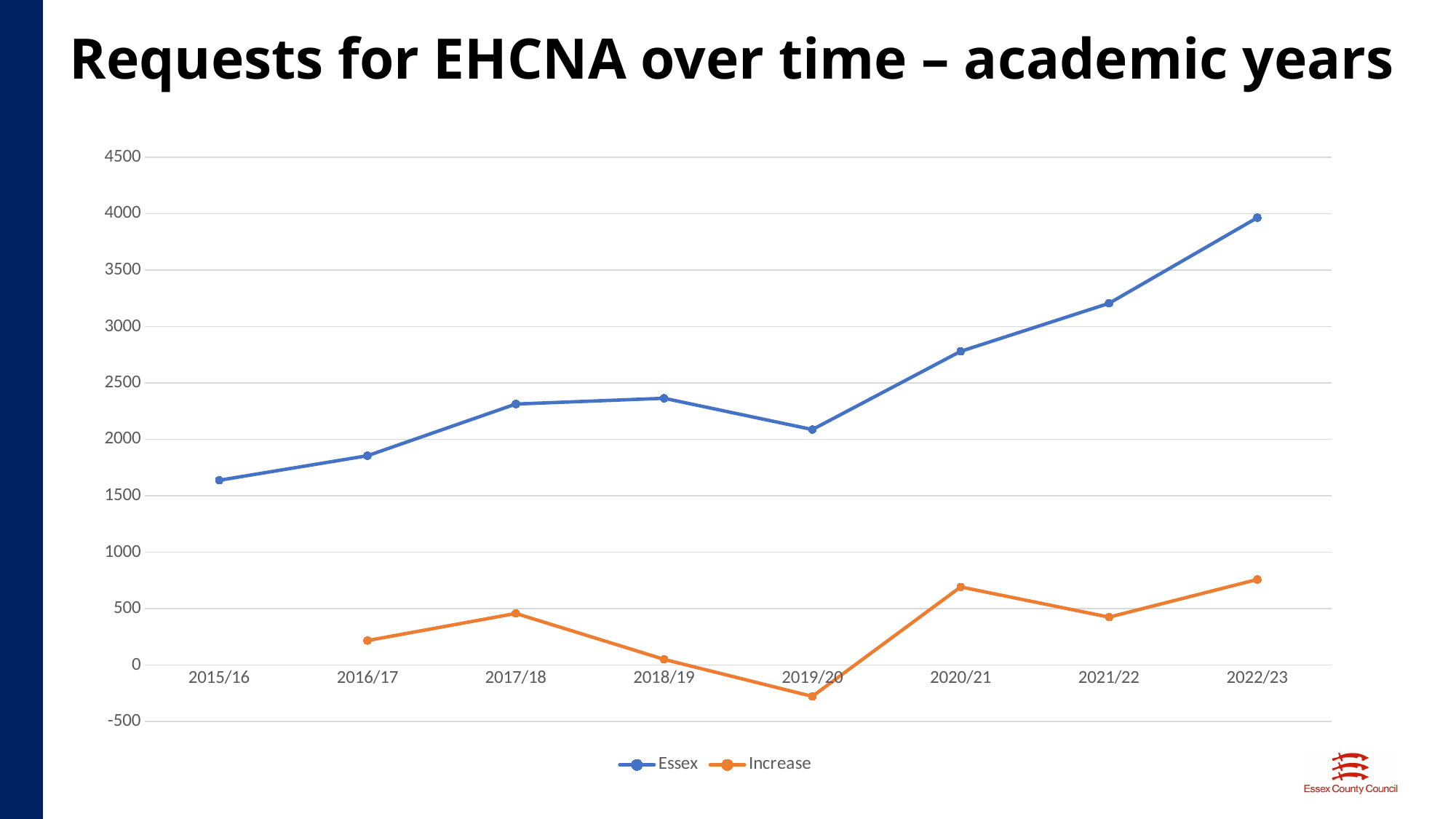
How many series does the legend list? 2 What kind of chart is shown on the slide? line chart In which academic year is the Essex series highest? 2022/23 Is the Essex value for 2019/20 greater or less than 2500? less In which academic year is the Essex series lowest? 2015/16 How many academic years are shown on the x axis? 8 Is the Increase value for 2019/20 greater or less than 0? less What is the title of the chart? Requests for EHCNA over time – academic years Does the Essex series rise or fall between 2015/16 and 2022/23 overall? rise In which academic year is the Increase series lowest? 2019/20 Which is larger for the Essex series: the value for 2019/20 or the value for 2020/21? 2020/21 Is the Essex value for 2022/23 greater or less than 3500? greater